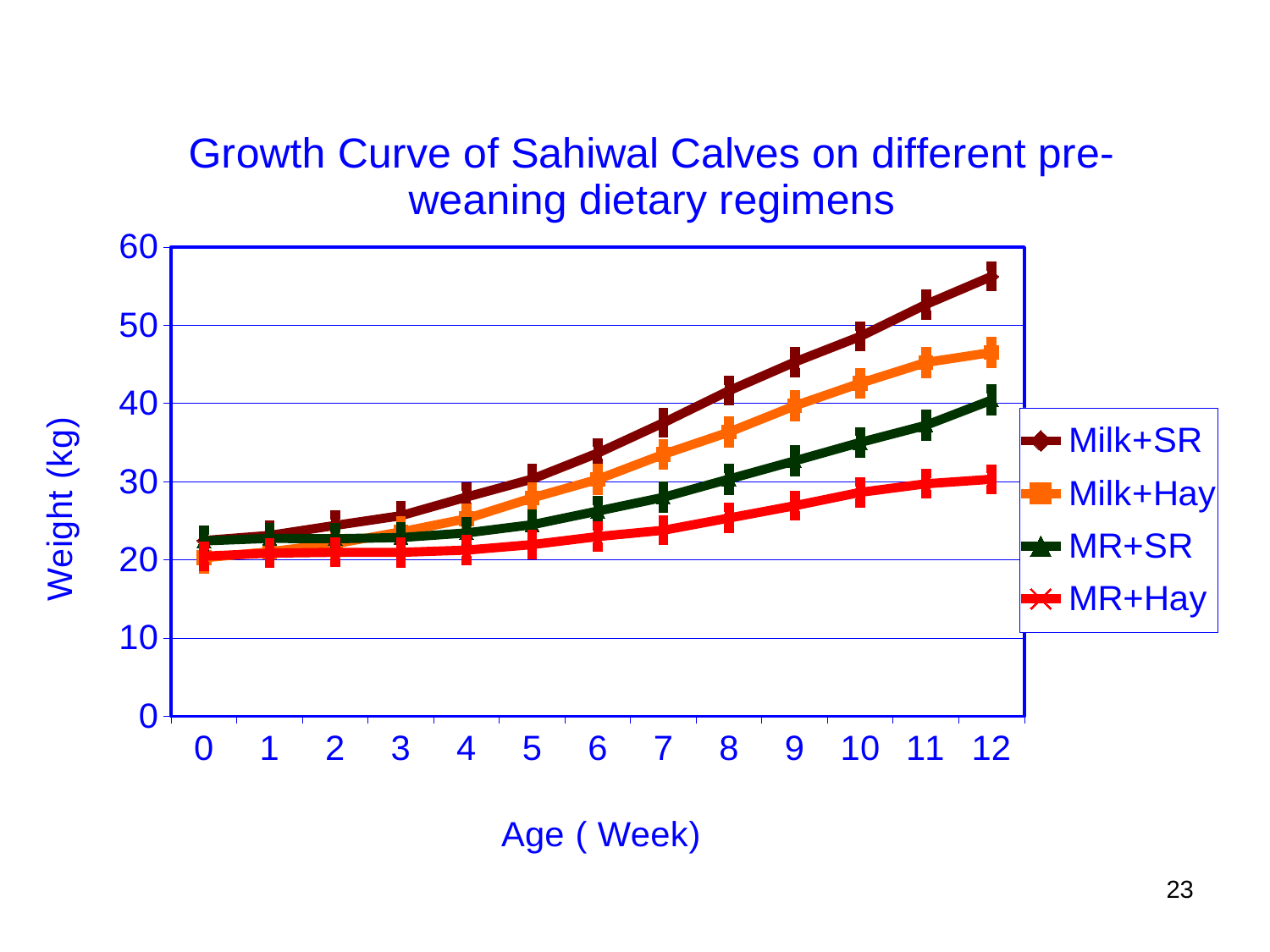
What is the title of the chart? Growth Curve of Sahiwal Calves on different pre-weaning dietary regimens Is the weight for Milk+SR at week 12 greater or less than 50? greater Which dietary regimen has the lowest weight at week 12? MR+Hay How many series does the legend list? 4 What kind of chart is shown on the slide? line chart What is the label of the y axis? Weight (kg) Does the weight for Milk+SR rise or fall as age increases from week 0 to week 12? rise Is the weight for MR+Hay at week 8 greater or less than 30? less Which dietary regimen has the highest weight at week 12? Milk+SR Is the weight for Milk+Hay at week 12 greater or less than 50? less At week 12, which is larger: the weight for Milk+Hay or for MR+SR? Milk+Hay How many age points (weeks) are plotted along the x axis? 13